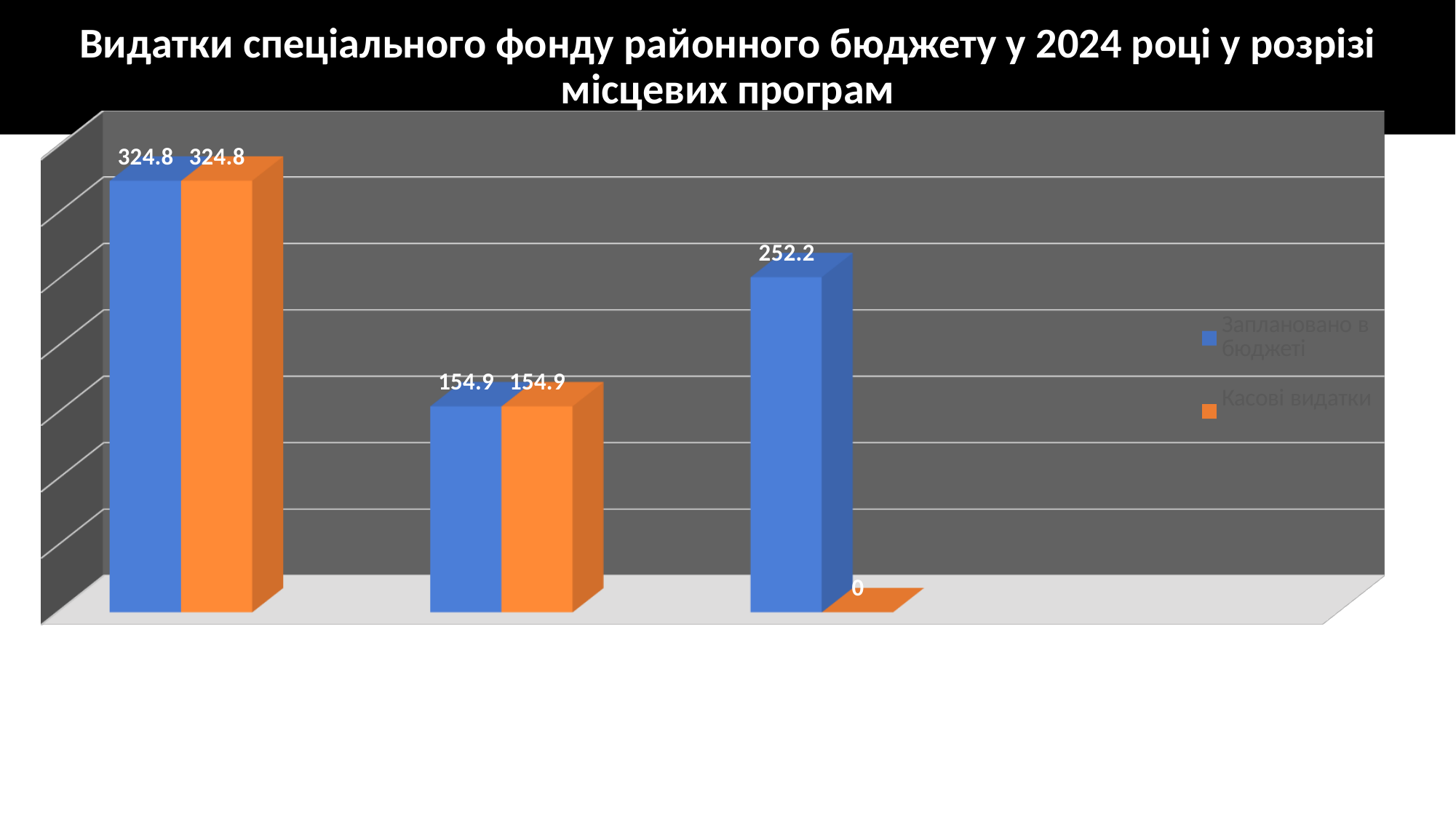
How many groups of bars are plotted in the chart? 3 Which is larger: the 'Заплановано в бюджеті' value in the middle group or in the rightmost group? the rightmost group What kind of chart is shown on the slide? bar chart Which series is shown in orange in the legend? Касові видатки In the rightmost group, what is the difference between 'Заплановано в бюджеті' and 'Касові видатки'? 252.2 What is the difference between the 'Заплановано в бюджеті' values of the leftmost and rightmost groups? 72.6 Which group has the lowest 'Касові видатки' value? the rightmost group How many series does the legend list? 2 What is the value of the 'Касові видатки' bar in the middle group? 154.9 Which group has the highest 'Заплановано в бюджеті' value? the leftmost group What is the value of the orange 'Касові видатки' bar in the rightmost group? 0 What is the value of the blue 'Заплановано в бюджеті' bar in the leftmost group? 324.8